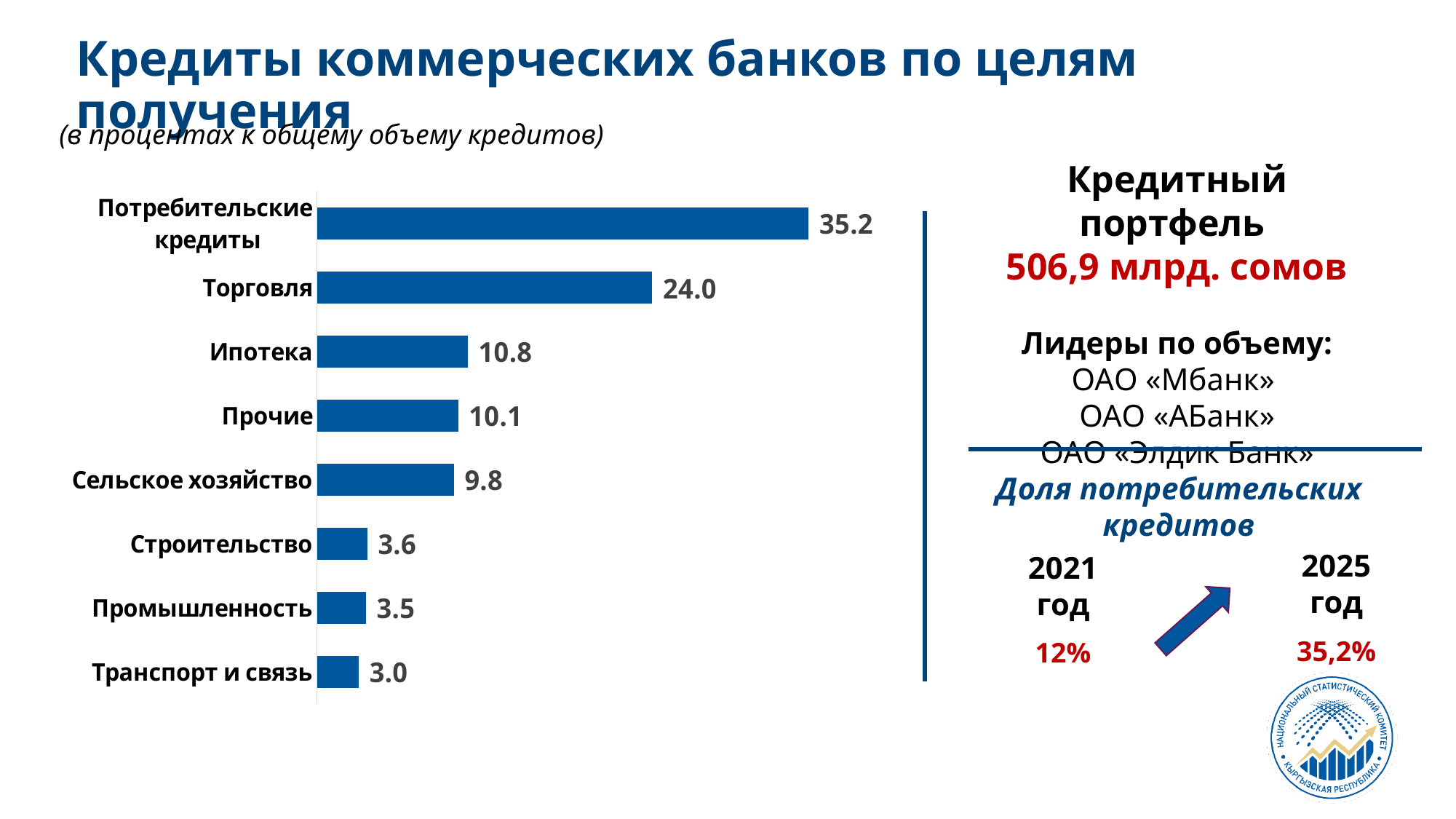
What is the value for Торговля? 24.0 Which is larger, the value for Строительство or the value for Промышленность? Строительство Which category has the lowest value? Транспорт и связь What is the difference between the values for Потребительские кредиты and Торговля? 11.2 What is the value for Транспорт и связь? 3.0 Which category has the highest value? Потребительские кредиты How many categories are shown in the chart? 8 What is the value for Сельское хозяйство? 9.8 What is the difference between the values for Ипотека and Прочие? 0.7 What kind of chart is shown on the slide? bar chart What is the value for Ипотека? 10.8 What is the value for Прочие? 10.1